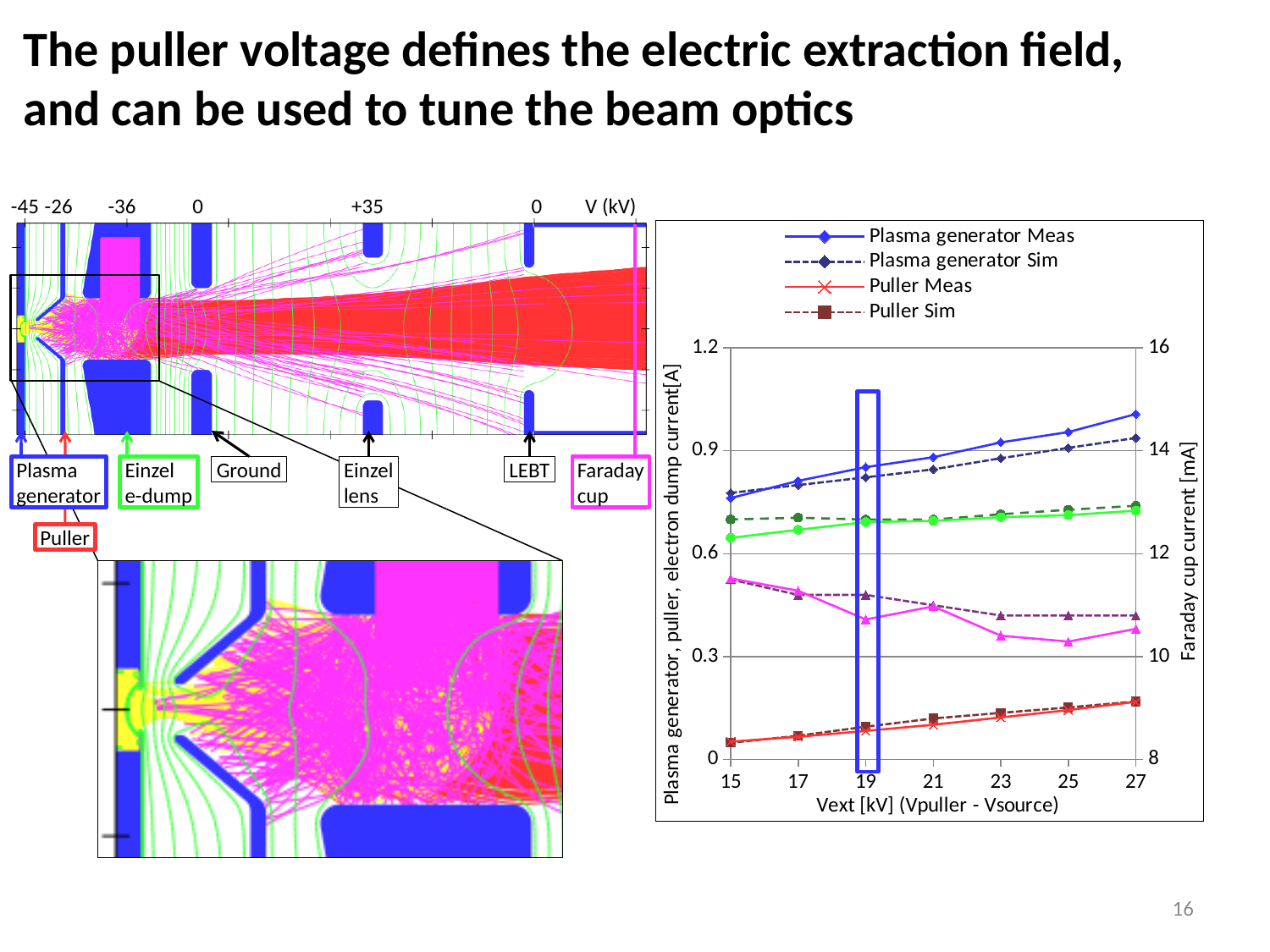
Is the Plasma generator Meas value at Vext 27 kV greater or less than 0.9 on the left axis? greater Does the Plasma generator Meas series rise or fall as Vext increases from 15 to 27 kV? rise Does the Puller Meas series rise or fall as Vext increases along the x axis? rise How many Vext values are marked along the x axis of the chart? 7 At Vext 21 kV, which is larger: Plasma generator Meas or Puller Meas? Plasma generator Meas Is the Plasma generator Sim value at Vext 15 kV greater or less than 0.6 on the left axis? greater What is the title of the x axis of the chart? Vext [kV] (Vpuller - Vsource) At which Vext value is the Plasma generator Meas series highest? 27 What kind of chart is shown on the slide? line chart Is the Puller Sim value at Vext 27 kV greater or less than 0.3 on the left axis? less At which Vext value is the Puller Meas series lowest? 15 How many series does the chart legend list? 4